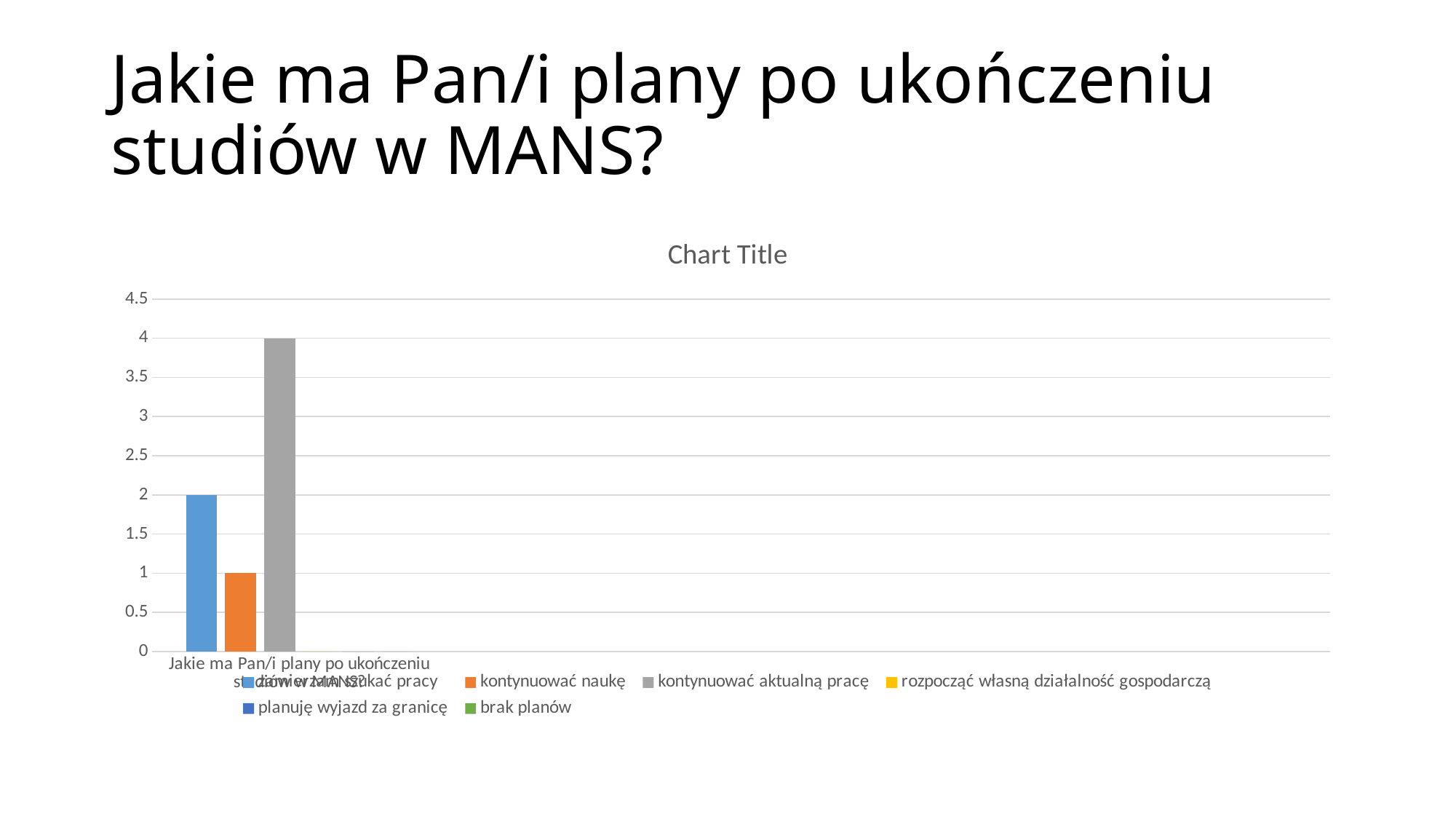
What kind of chart is shown on the slide? bar chart What is the value for "kontynuować naukę"? 1 Which of the plotted bars is the lowest? kontynuować naukę What is the title shown above the chart? Chart Title How many series does the legend list? 6 What is the difference between the values for "kontynuować aktualną pracę" and "kontynuować naukę"? 3 Which series has the highest bar? kontynuować aktualną pracę Is the value for "kontynuować aktualną pracę" greater or less than 3? greater Which is larger, the value for "kontynuować naukę" or for "kontynuować aktualną pracę"? kontynuować aktualną pracę What value does the light blue bar (the first series) reach? 2 What is the value for "kontynuować aktualną pracę"? 4 How many bars are plotted on the chart? 3